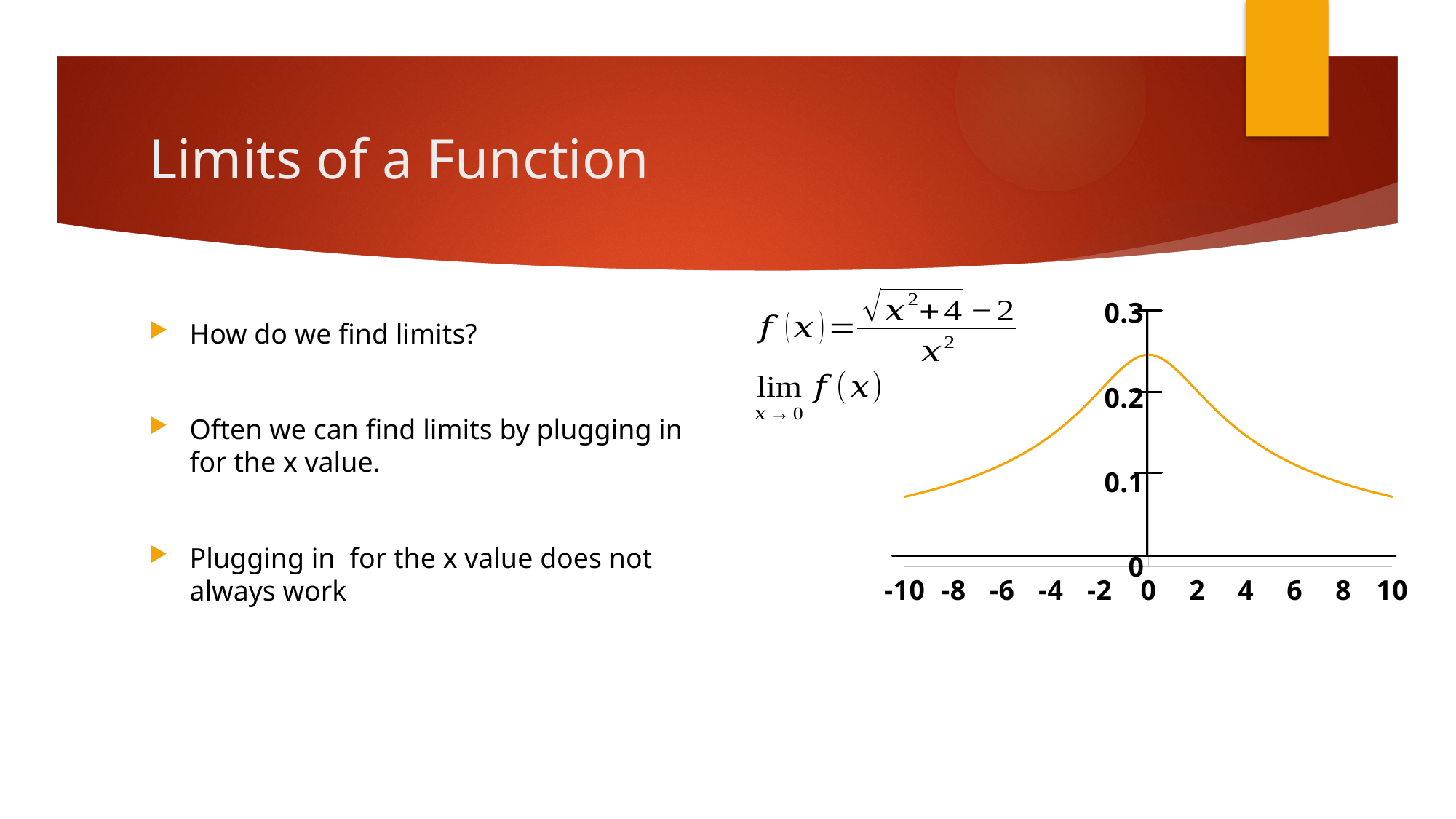
Does the curve rise or fall as x goes from -10 to 0? rise What kind of chart is shown on the right of the slide? line chart Is the value of the curve at x = -10 greater or less than 0.1? less Is the value of the curve at x = 0 greater or less than 0.2? greater How many tick labels are shown on the x axis? 11 Which is larger, the value of the curve at x = -4 or at x = -8? x = -4 Is the value of the curve at x = 10 greater or less than 0.1? less Does the curve rise or fall as x goes from 0 to 10? fall At which x value does the plotted curve reach its highest point? 0 What colour is the plotted curve? orange